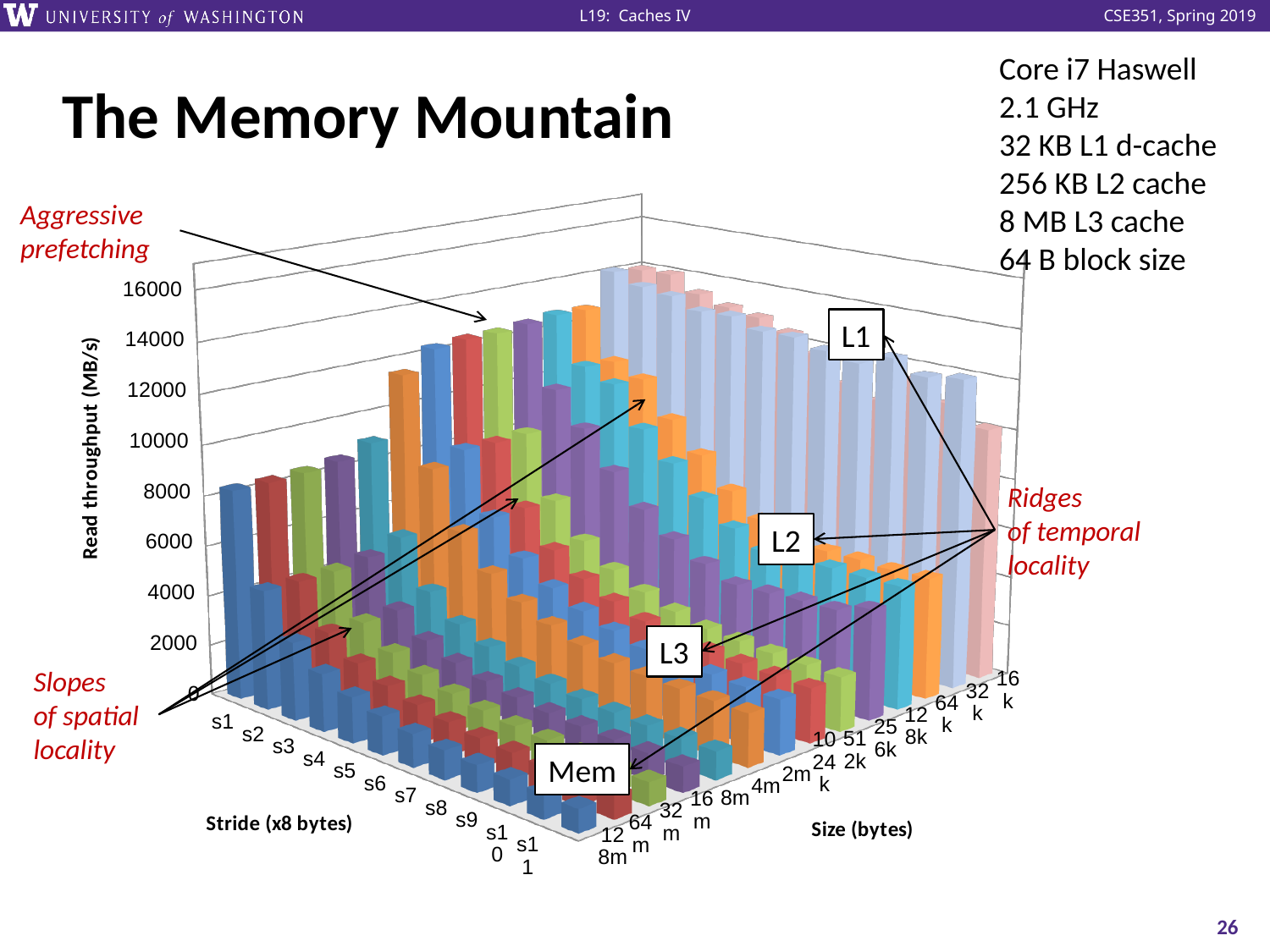
What is the label of the vertical axis of the chart? Read throughput (MB/s) What is the highest tick value shown on the Read throughput axis? 16000 Is the read throughput for stride s1 at size 16k greater or less than 10000? greater Which stride has the highest read throughput for a given working-set size? s1 For a fixed stride, does read throughput rise or fall as the size increases from 16k to 128m? fall How many size categories are shown along the Size (bytes) axis? 14 For a fixed size, does read throughput rise or fall as the stride increases from s1 to s11? fall What kind of chart is shown on the slide? 3D bar chart How many stride categories (s1 through s11) are shown along the stride axis? 11 What is the title of the chart on the slide? The Memory Mountain Is the read throughput for stride s1 at size 128m greater or less than 14000? less